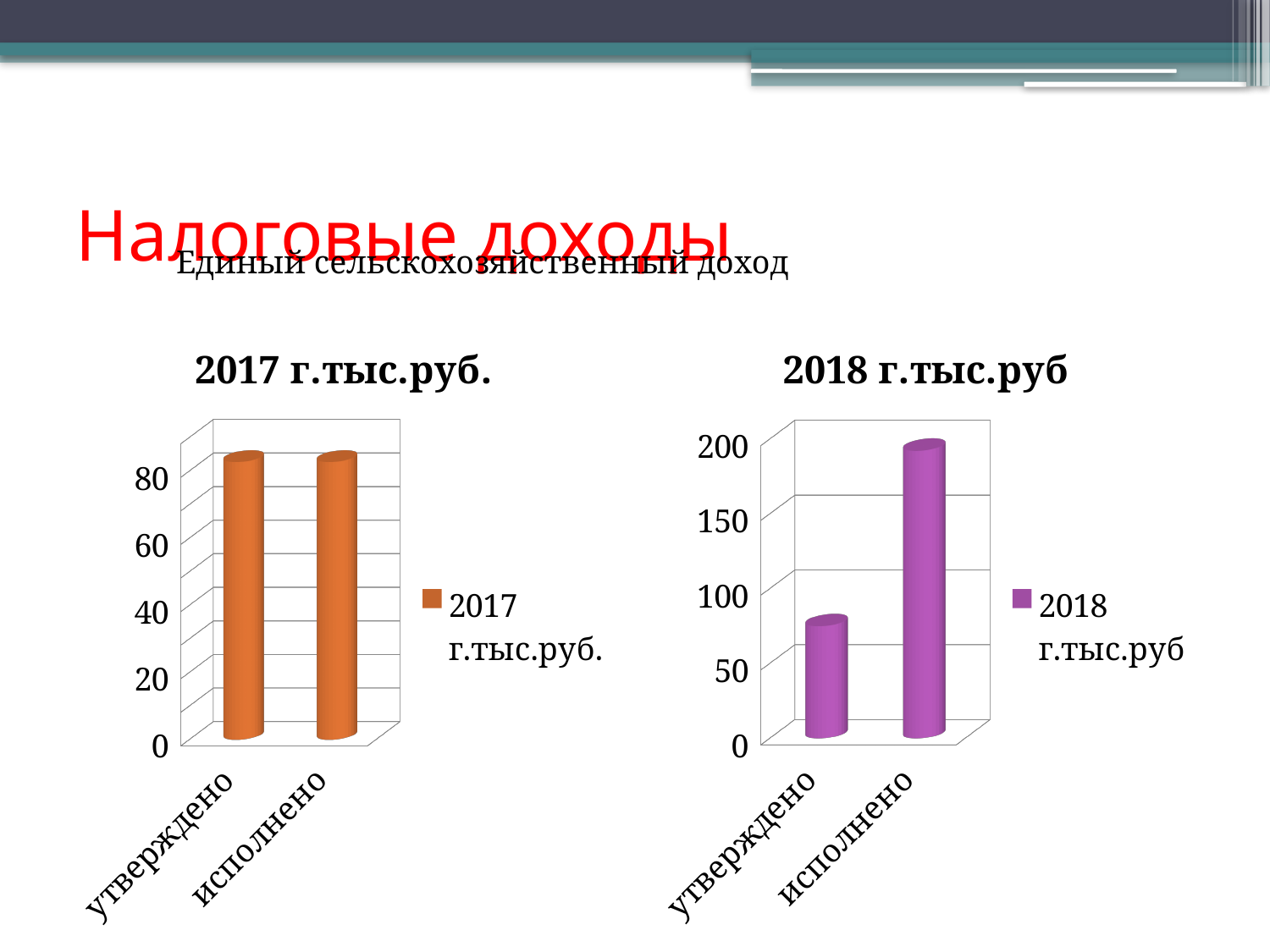
How many series does the legend of the chart titled "2017 г.тыс.руб." list? 1 What colour are the bars in the chart titled "2017 г.тыс.руб."? orange In the chart titled "2018 г.тыс.руб", is the value for исполнено greater or less than 150? greater In the chart titled "2018 г.тыс.руб", which category has the highest value? исполнено In the chart titled "2017 г.тыс.руб.", is the value for утверждено greater or less than 60? greater What kind of chart is the chart titled "2017 г.тыс.руб."? bar chart How many categories are shown on the x axis of the chart titled "2018 г.тыс.руб"? 2 In the chart titled "2018 г.тыс.руб", is the value for утверждено greater or less than 100? less In the chart titled "2018 г.тыс.руб", which is larger, утверждено or исполнено? исполнено In the chart titled "2018 г.тыс.руб", which category has the lowest value? утверждено What is the legend entry of the chart on the right side of the slide? 2018 г.тыс.руб